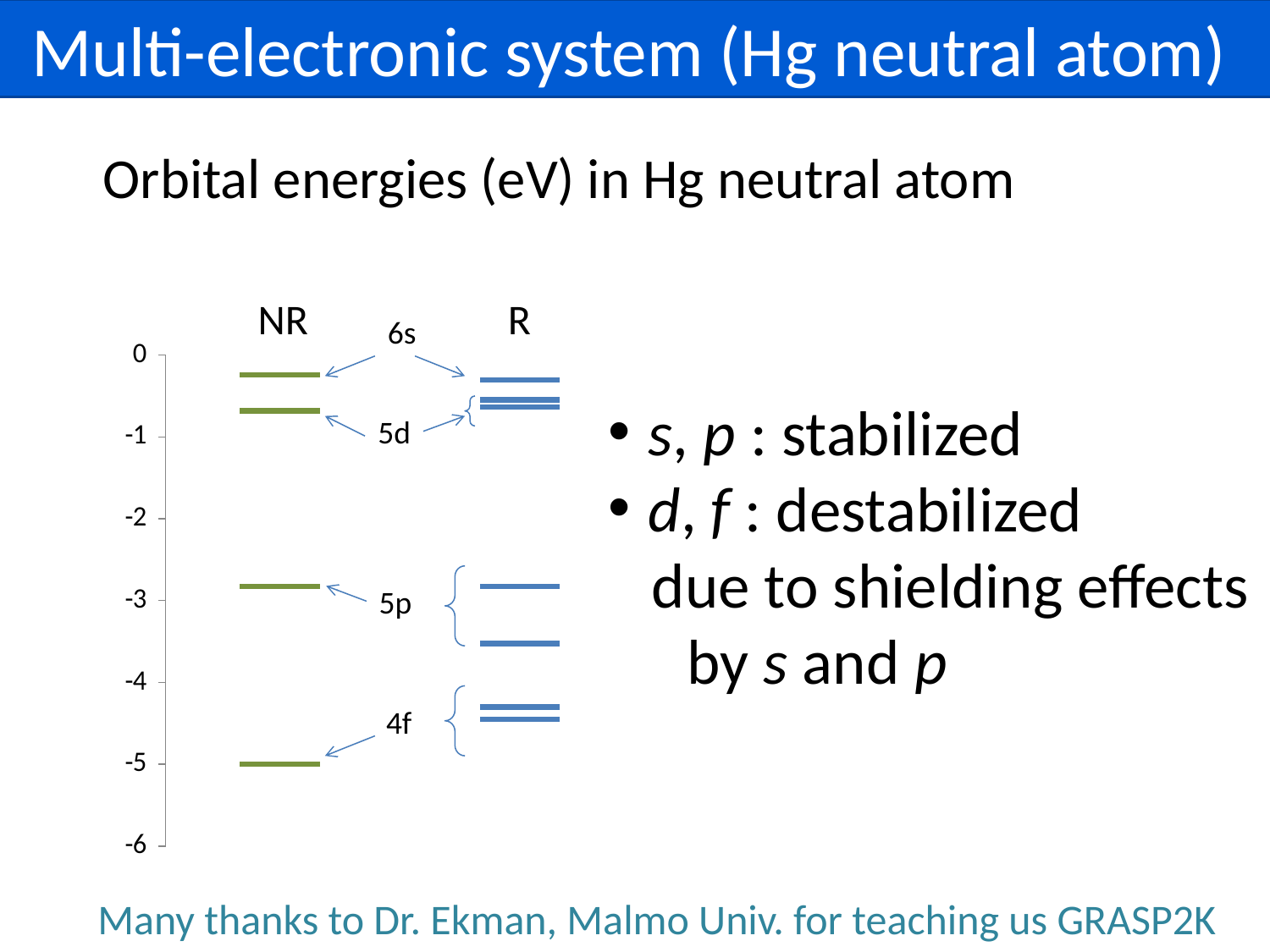
How many orbitals are labelled in the orbital energies chart? 4 In the orbital energies chart, which orbital has the lowest energy level shown? 4f (NR) In the orbital energies chart, is the NR 5p level greater or less than -2 eV? less What is the lowest value shown on the vertical axis of the orbital energies chart? -6 What colour are the energy levels in the R column of the chart? Blue In the orbital energies chart, is the NR 4f level greater or less than -4 eV? less In the orbital energies chart, which is lower in energy: the NR 4f level or the R 4f levels? NR 4f How many energy levels are drawn in the NR column of the chart? 4 In the orbital energies chart, is the NR 6s level greater or less than -1 eV? greater